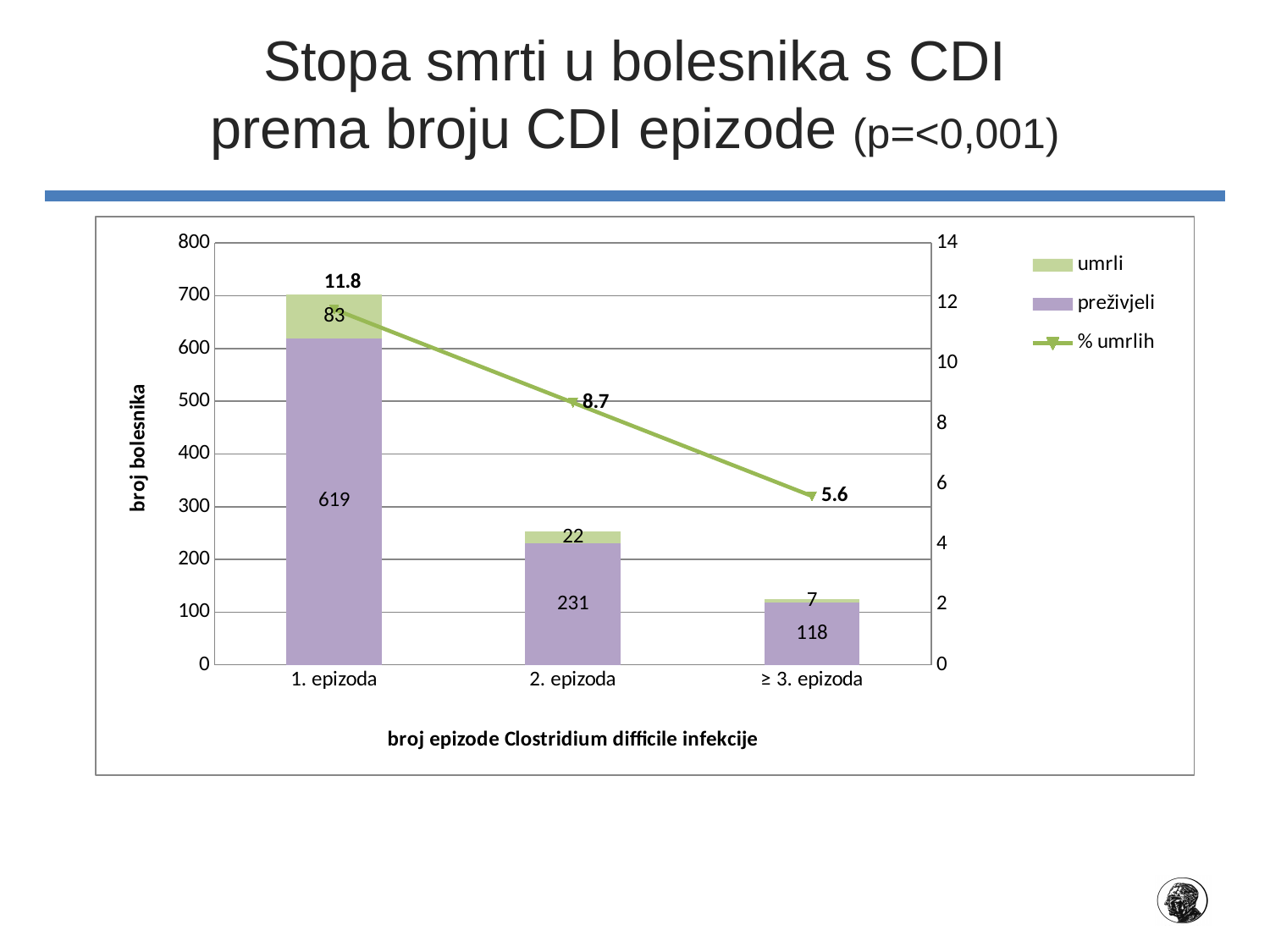
What is the '% umrlih' value for '≥ 3. epizoda'? 5.6 How many categories are shown on the x axis? 3 What is the value of 'umrli' for '1. epizoda'? 83 Which category has the highest '% umrlih' value? 1. epizoda How many series does the legend list? 3 What is the value of 'umrli' for '2. epizoda'? 22 Which is larger: the 'umrli' value for '2. epizoda' or for '≥ 3. epizoda'? 2. epizoda Which category has the lowest 'preživjeli' value? ≥ 3. epizoda What is the difference between the 'preživjeli' values for '2. epizoda' and '≥ 3. epizoda'? 113 What is the total of the stacked bar for '1. epizoda'? 702 Does the '% umrlih' line rise or fall from '1. epizoda' to '≥ 3. epizoda'? fall What is the value of 'preživjeli' for '1. epizoda'? 619